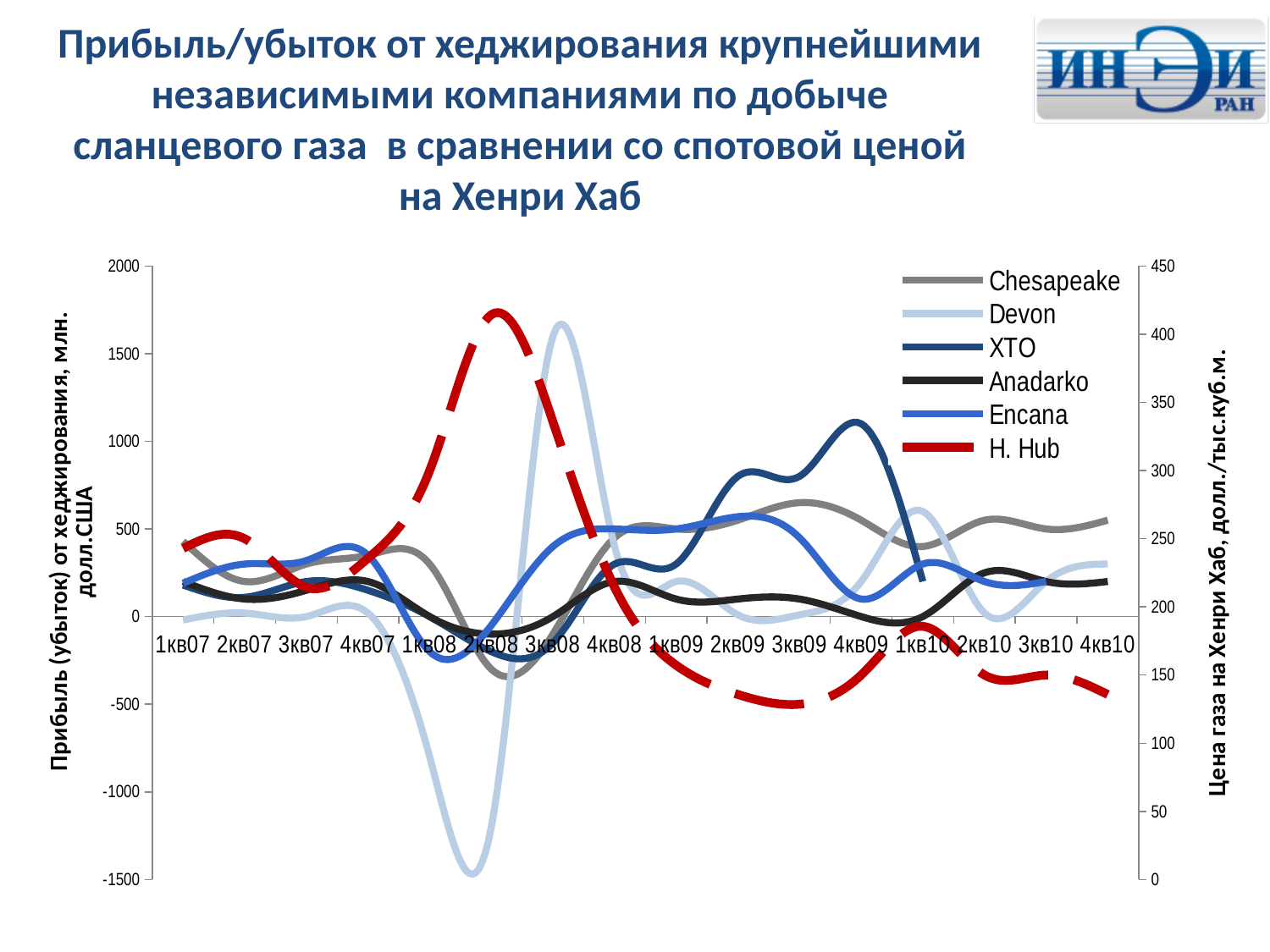
Is the value for Chesapeake at 2кв08 greater or less than 0? less What is the label of the right-hand vertical axis? Цена газа на Хенри Хаб, долл./тыс.куб.м. Is the value for Devon at 2кв08 greater or less than -1000? less Is the value for Devon at 3кв08 greater or less than 1500? greater How many quarters are shown along the x axis? 16 Which series is drawn as a dashed line? H. Hub How many series does the legend list? 6 Which series reaches the highest hedging profit value on the chart? Devon What kind of chart is shown on the slide? line chart Which series reaches the lowest value on the chart? Devon